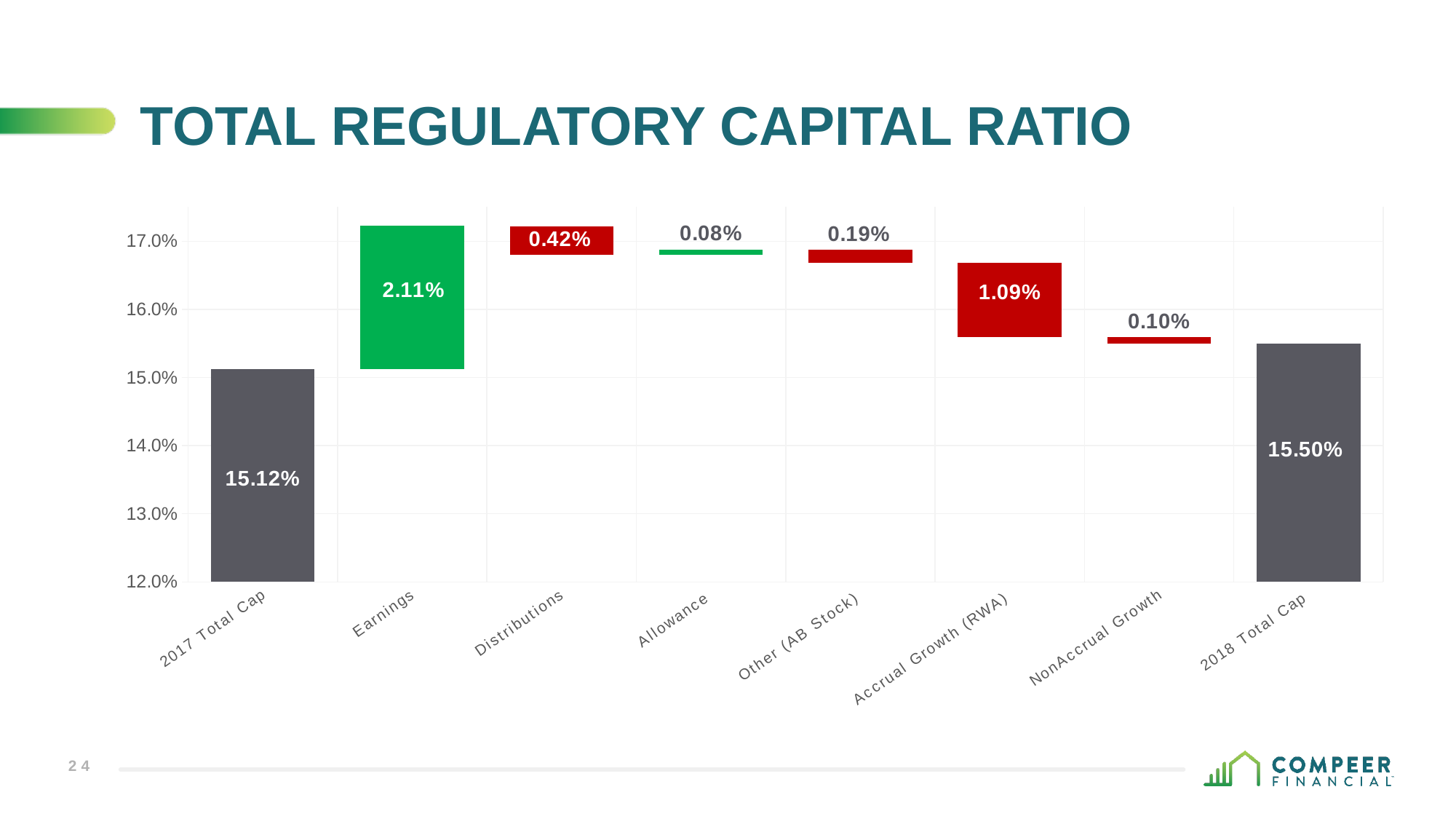
What is the value labelled for NonAccrual Growth? 0.10% What colour are the bars for Distributions, Other (AB Stock), Accrual Growth (RWA) and NonAccrual Growth? Red What is the value shown for 2018 Total Cap? 15.50% What is the value labelled on the Earnings bar? 2.11% What is the value labelled for Accrual Growth (RWA)? 1.09% What is the value shown for 2017 Total Cap? 15.12% By how much does the 2018 Total Cap exceed the 2017 Total Cap? 0.38% How many categories are shown on the x axis? 8 Which of the adjustment items between the two total bars has the smallest labelled value? Allowance Which of the adjustment items between the two total bars has the largest labelled value? Earnings Which is larger, the value for Distributions or the value for Other (AB Stock)? Distributions What is the value labelled for Distributions? 0.42%